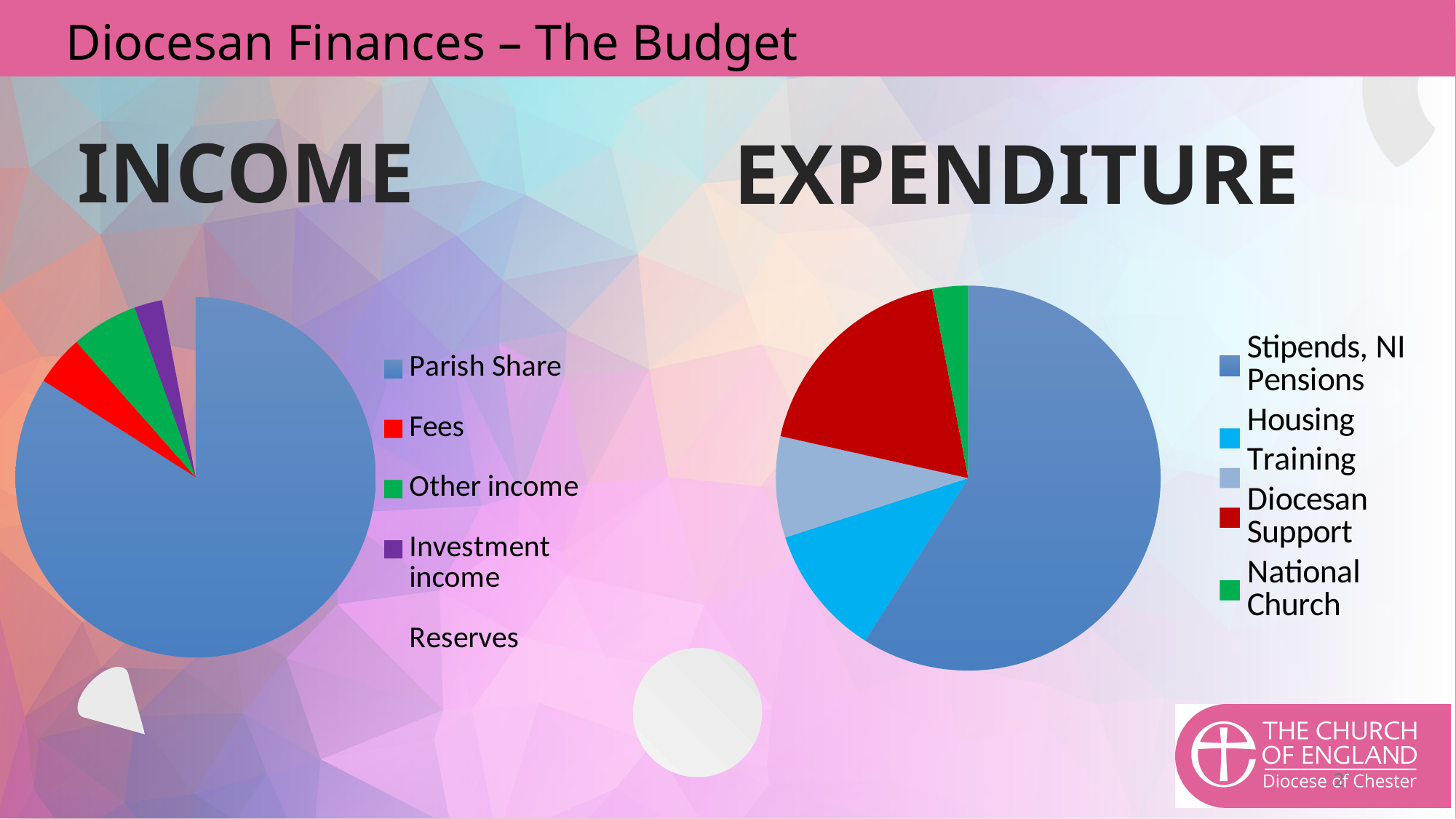
In the EXPENDITURE chart, which is larger: Diocesan Support or Housing? Diocesan Support In the INCOME chart, which category has the largest slice? Parish Share In the INCOME chart, which is larger: Other income or Investment income? Other income How many entries does the legend of the EXPENDITURE chart list? 5 In the EXPENDITURE chart, which category has the smallest slice? National Church In the EXPENDITURE chart, which category has the largest slice? Stipends, NI Pensions In the EXPENDITURE chart, which is larger: Training or National Church? Training What kind of chart is the EXPENDITURE chart? pie chart What kind of chart is the INCOME chart? pie chart How many entries does the legend of the INCOME chart list? 5 In the INCOME chart, what colour is the Fees slice? red